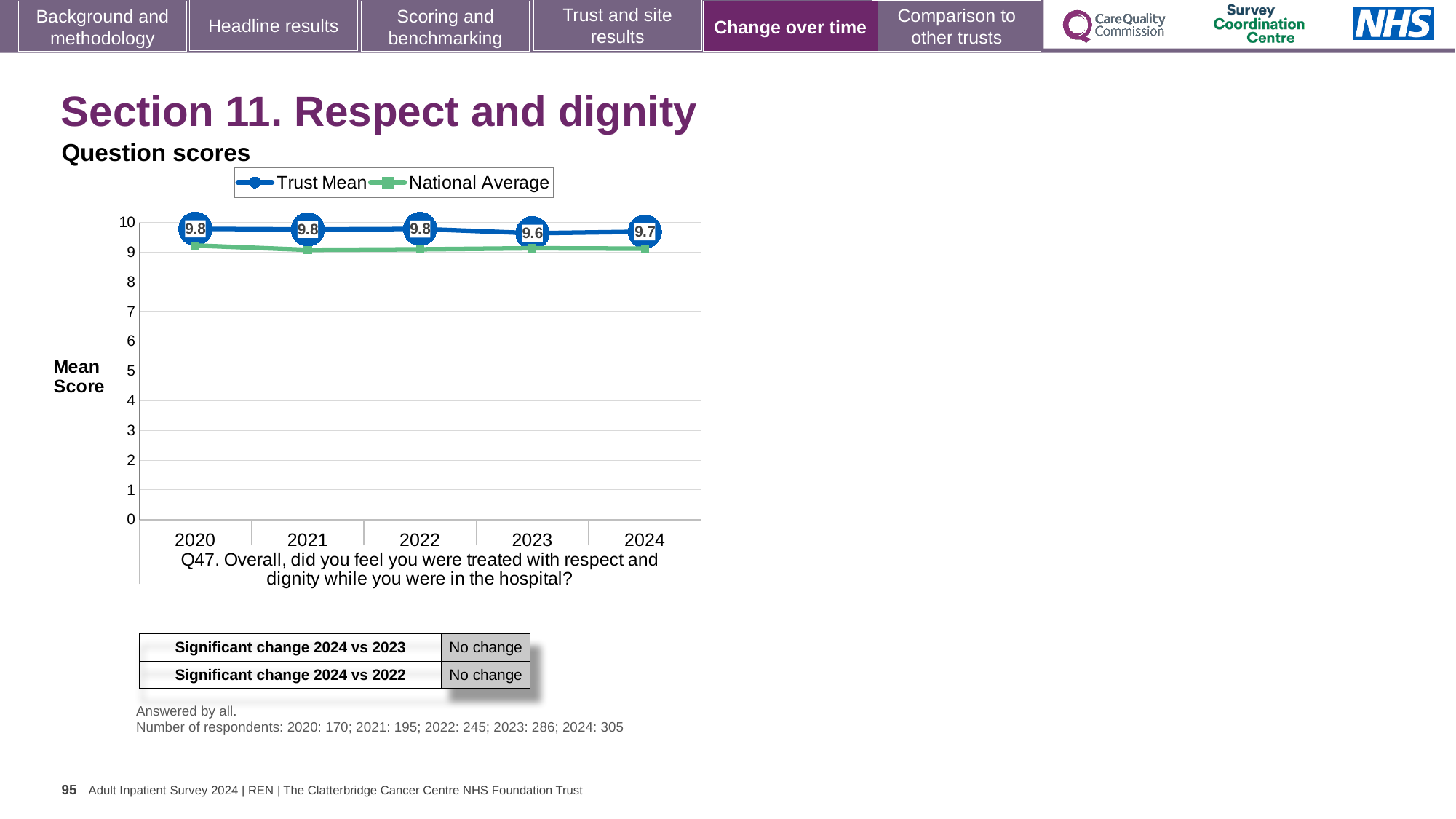
Which is larger, the Trust Mean score in 2023 or in 2024? 2024 Is the National Average value for 2021 greater or less than 8? greater What kind of chart is shown on the slide? Line chart Which series is plotted in blue? Trust Mean In which year is the Trust Mean score lowest? 2023 What is the Trust Mean score for 2023? 9.6 What is the Trust Mean score for 2024? 9.7 Is the National Average value for 2024 greater or less than 9.5? less What is the Trust Mean score for 2020? 9.8 How many years are shown on the x axis? 5 What is the difference between the Trust Mean score in 2022 and in 2023? 0.2 How many series does the legend list? 2